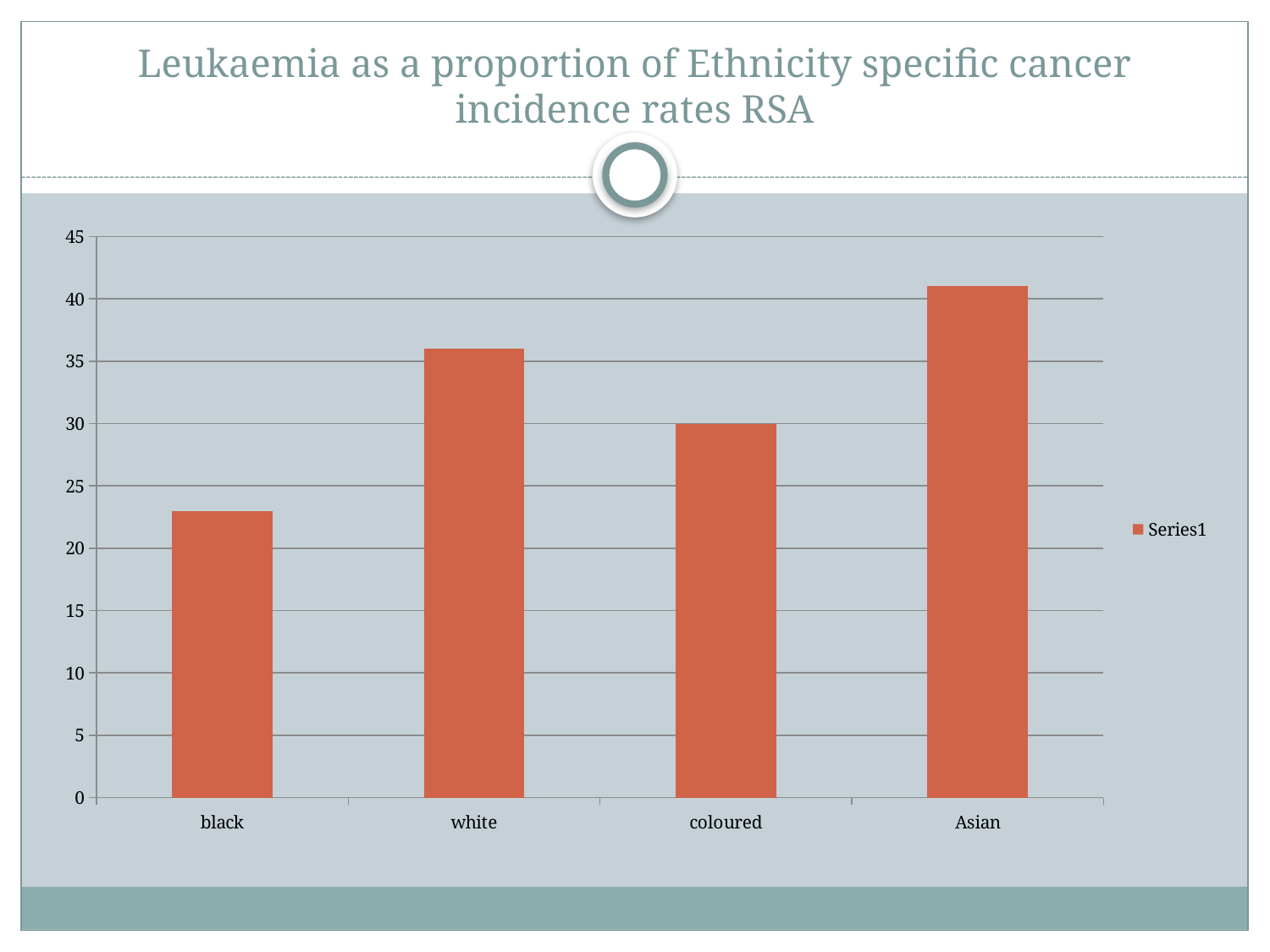
Is the value for Asian greater or less than 35? greater What type of chart is shown on the slide? bar chart What is the title of the slide containing the chart? Leukaemia as a proportion of Ethnicity specific cancer incidence rates RSA Is the value for white greater or less than 30? greater Which is larger, the value for white or the value for coloured? white What is the name of the series shown in the legend? Series1 How many series does the legend list? 1 What is the value for coloured? 30 Is the value for black greater or less than 25? less How many categories are shown on the x axis of the chart? 4 Which category has the lowest value in the chart? black Which category has the highest value in the chart? Asian